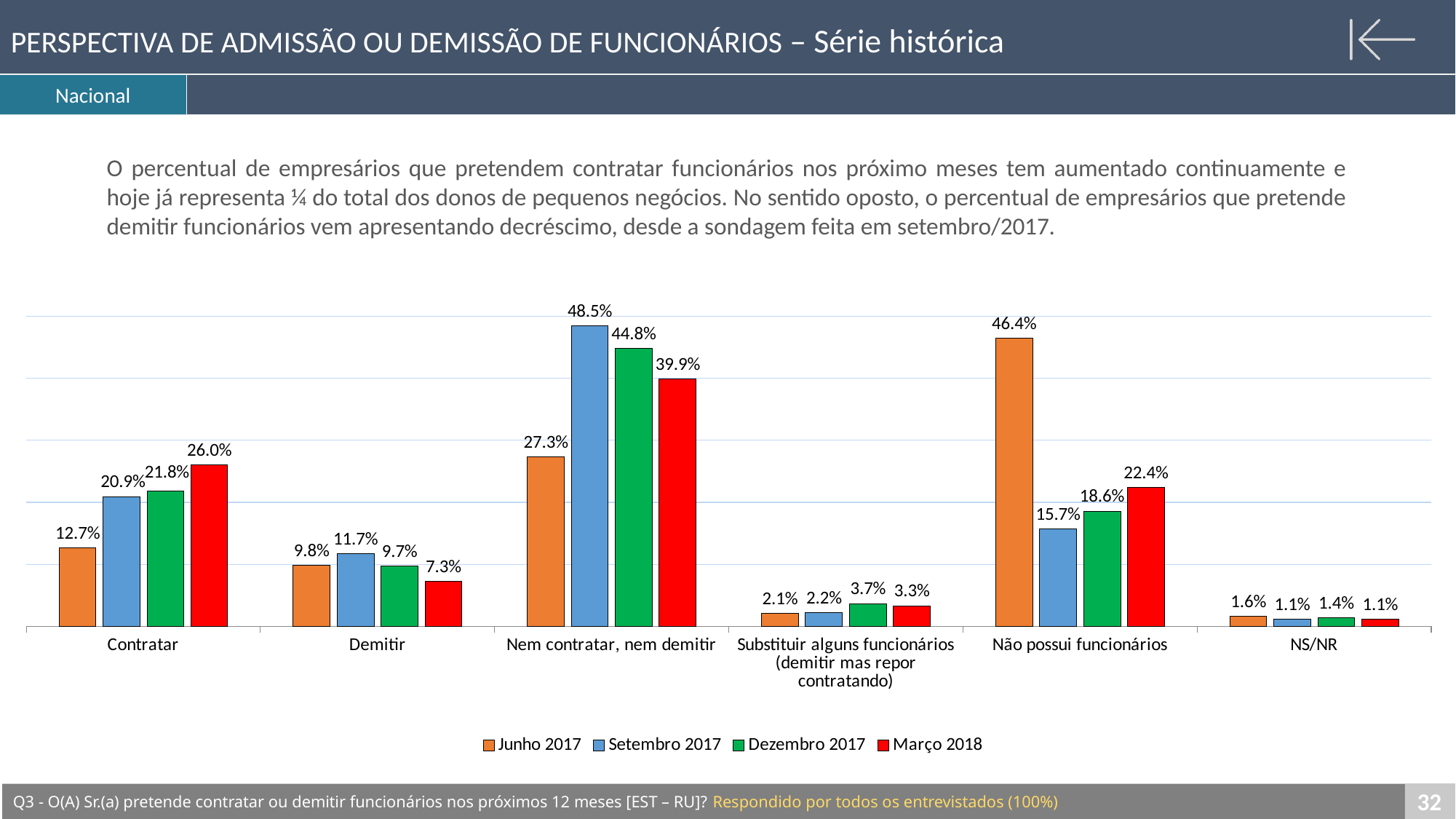
Which category has the lowest value in Março 2018? NS/NR What is the value for Demitir in Setembro 2017? 11.7% Which series is shown in red in the legend? Março 2018 How many categories are shown on the x axis? 6 What is the value for Contratar in Março 2018? 26.0% Which is larger for Não possui funcionários: the Setembro 2017 value or the Março 2018 value? Março 2018 Which category has the highest value in Setembro 2017? Nem contratar, nem demitir What is the value for Não possui funcionários in Junho 2017? 46.4% How many series does the legend list? 4 What is the difference between the Março 2018 and Junho 2017 values for Contratar? 13.3% Do the values for Contratar rise or fall from Junho 2017 to Março 2018? Rise What kind of chart is shown on the slide? Bar chart